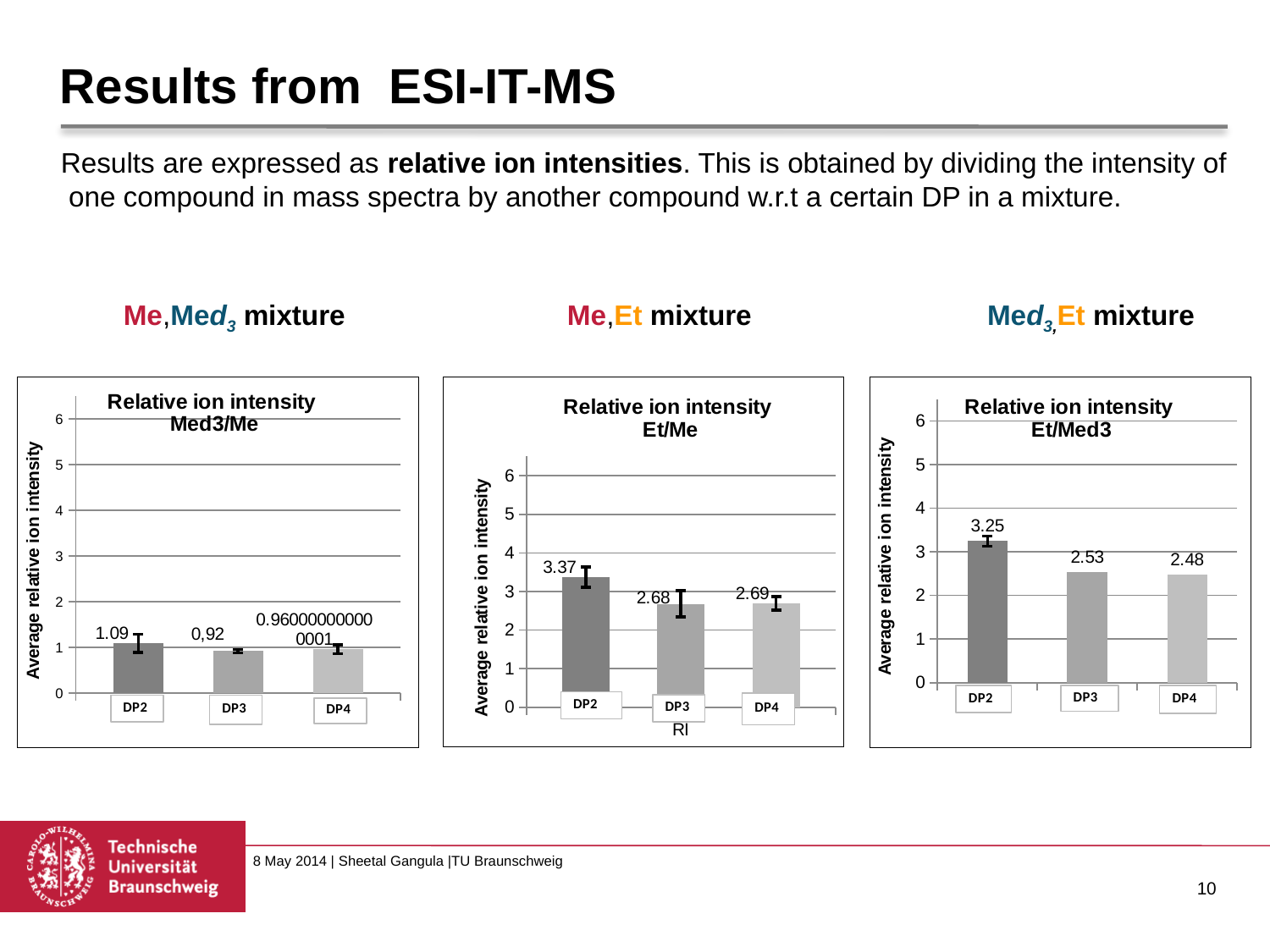
In the 'Relative ion intensity Med3/Me' chart, what is the value for DP3? 0,92 In the 'Relative ion intensity Et/Med3' chart, what is the value for DP4? 2.48 What type of chart is the 'Relative ion intensity Et/Me' chart? bar chart How many categories are shown in the 'Relative ion intensity Et/Med3' chart? 3 In the 'Relative ion intensity Et/Me' chart, which category has the highest value? DP2 In the 'Relative ion intensity Et/Me' chart, what is the value for DP2? 3.37 In the 'Relative ion intensity Et/Med3' chart, which category has the highest value? DP2 In the 'Relative ion intensity Et/Med3' chart, what is the difference between the DP2 and DP3 values? 0.72 In the 'Relative ion intensity Med3/Me' chart, what is the value for DP2? 1.09 In the 'Relative ion intensity Med3/Me' chart, is the value for DP2 greater or less than 2? less In the 'Relative ion intensity Et/Me' chart, what is the difference between the DP2 and DP3 values? 0.69 In the 'Relative ion intensity Et/Me' chart, what is the value for DP3? 2.68